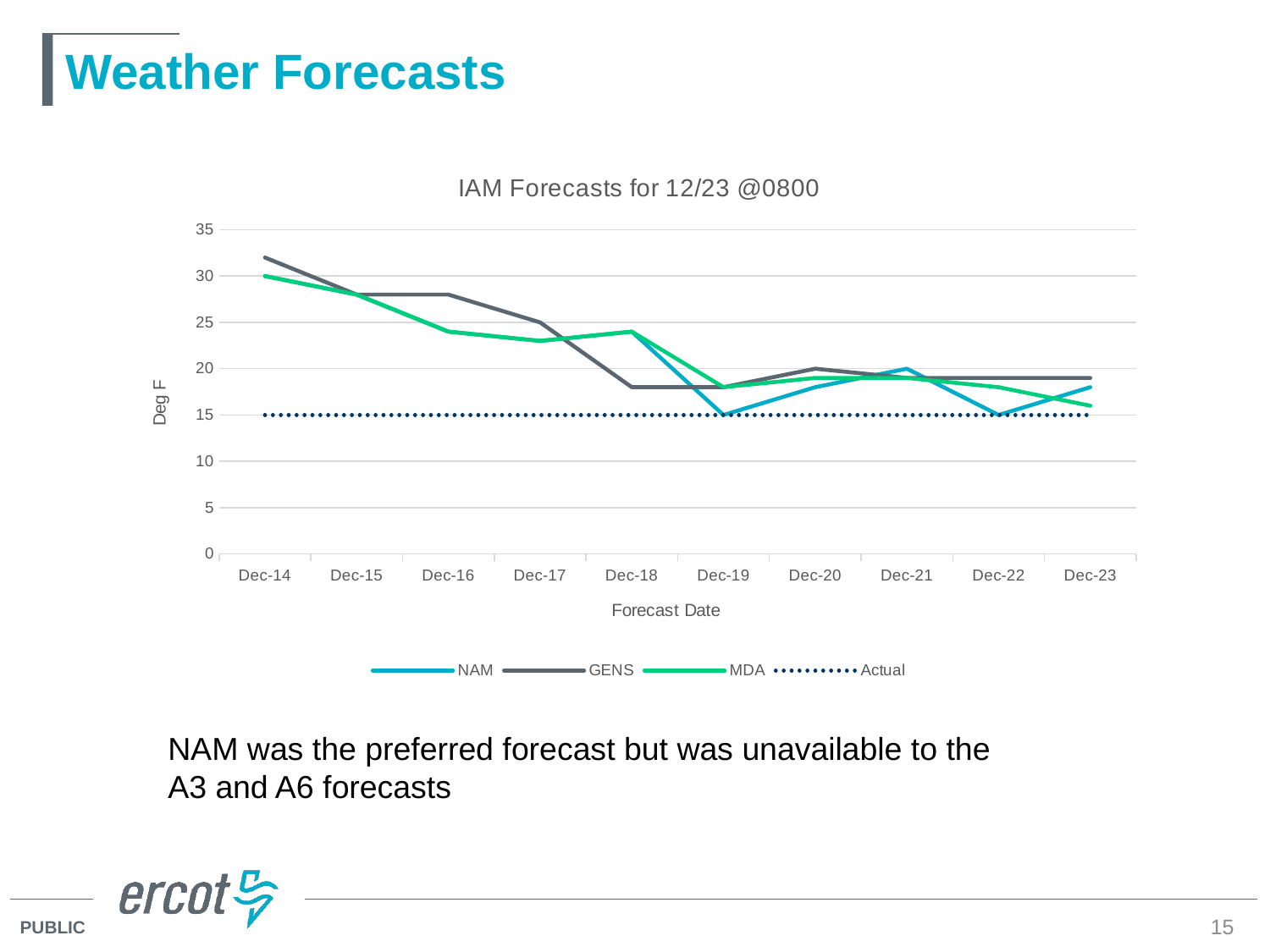
Which series has the highest value at Dec-14? GENS What is the label of the y axis? Deg F Is the GENS value for Dec-14 greater or less than 30? greater What is the value of the Actual series across the forecast dates? 15 What kind of chart is shown on the slide? line chart Is the GENS value for Dec-18 greater or less than 20? less What is the title of the chart? IAM Forecasts for 12/23 @0800 Does the GENS series rise or fall from Dec-14 to Dec-18? fall At Dec-18, which is higher, the GENS value or the MDA value? MDA How many series does the legend list? 4 Is the NAM value for Dec-16 greater or less than 25? less How many forecast dates are shown on the x axis? 10